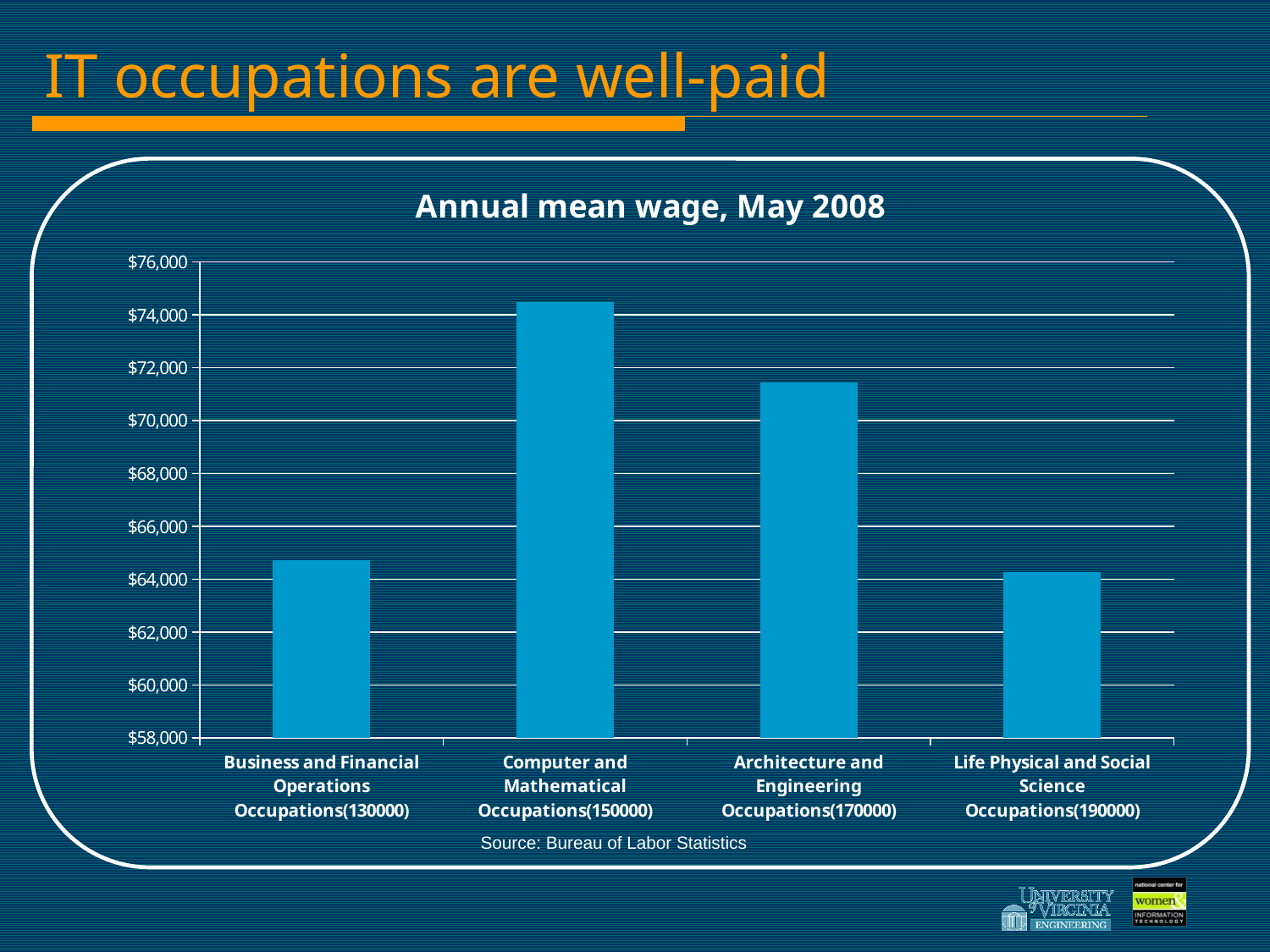
How many occupation categories are plotted in the chart? 4 Is the annual mean wage for Business and Financial Operations Occupations greater or less than $66,000? less Is the annual mean wage for Architecture and Engineering Occupations greater or less than $72,000? less Is the annual mean wage for Architecture and Engineering Occupations greater or less than $70,000? greater Which occupation category has the highest annual mean wage? Computer and Mathematical Occupations(150000) Which is larger, the annual mean wage for Computer and Mathematical Occupations or for Architecture and Engineering Occupations? Computer and Mathematical Occupations Which is larger, the annual mean wage for Architecture and Engineering Occupations or for Business and Financial Operations Occupations? Architecture and Engineering Occupations What kind of chart is shown on the slide? bar chart What is the title of the chart? Annual mean wage, May 2008 What source is cited below the chart? Bureau of Labor Statistics